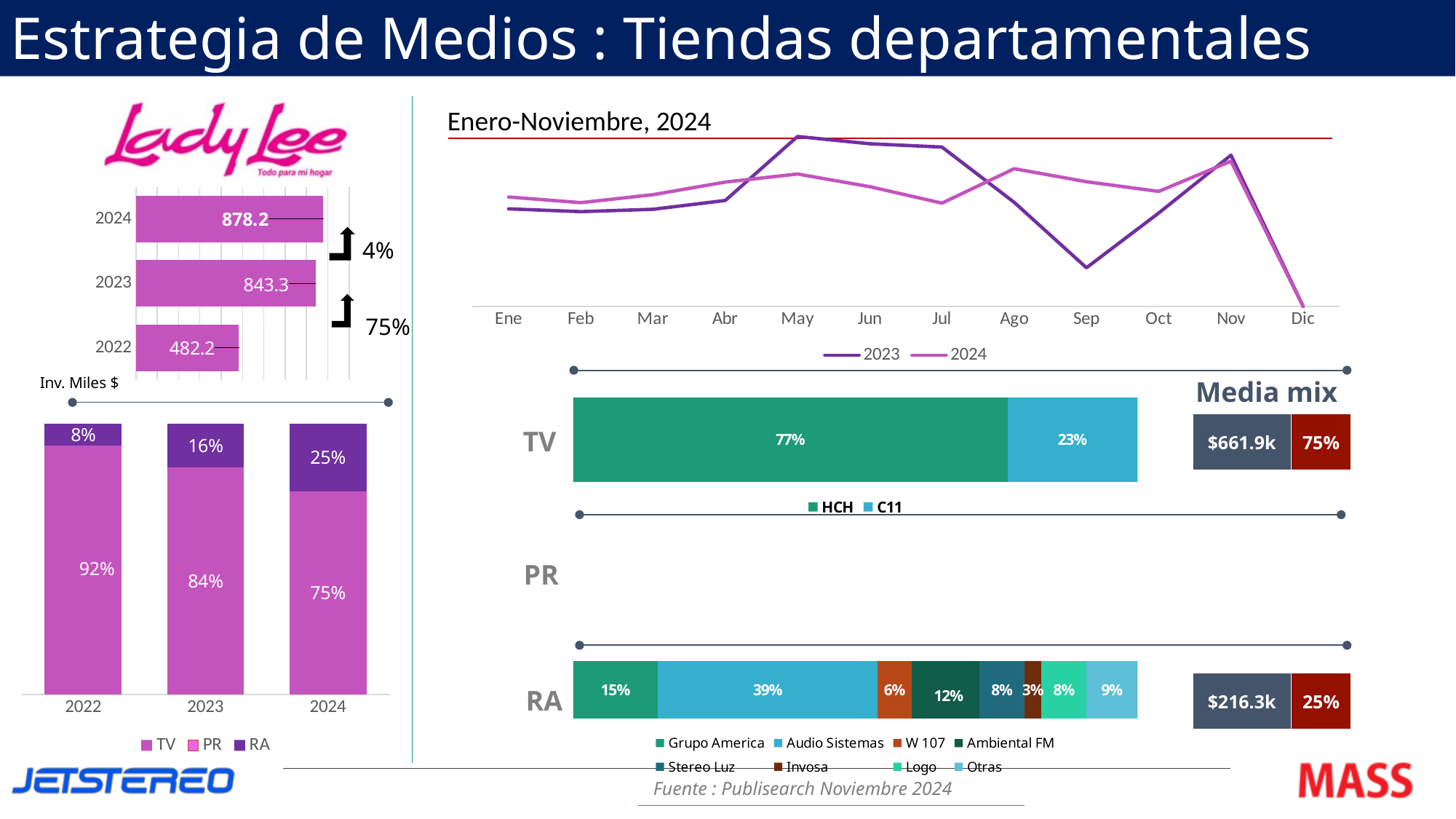
In the stacked bar chart of TV/PR/RA by year (bottom left), how many series does the legend list? 3 In the TV stacked bar (right side), what is the share for HCH? 77% In the horizontal bar chart of investment by year (top left), which year has the lowest value? 2022 In the stacked bar chart of TV/PR/RA by year (bottom left), what is the TV share for 2023? 84% In the line chart titled Enero-Noviembre, 2024, what type of chart is it? line chart In the horizontal bar chart of investment by year (top left), what is the value for 2024? 878.2 In the stacked bar chart of TV/PR/RA by year (bottom left), what is the RA share for 2024? 25% In the horizontal bar chart of investment by year (top left), what is the value for 2022? 482.2 In the horizontal bar chart of investment by year (top left), what is the difference between the 2024 and 2023 values? 34.9 In the line chart titled Enero-Noviembre, 2024, how many months are shown on the x axis? 12 In the stacked bar chart of TV/PR/RA by year (bottom left), does the TV share rise or fall from 2022 to 2024? fall In the RA stacked bar (right side), which station has the largest share? Audio Sistemas